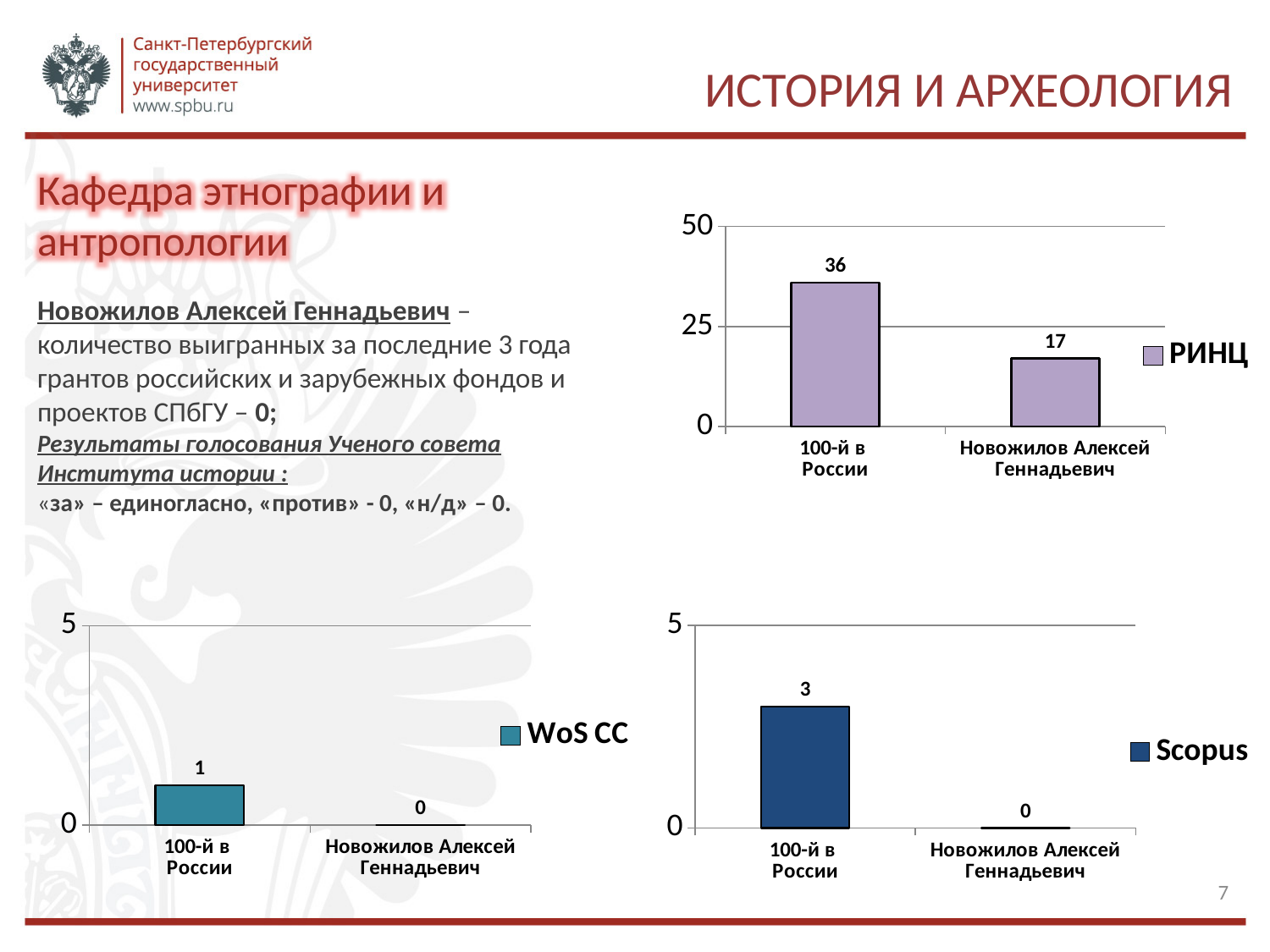
In the РИНЦ chart, is the value for Новожилов Алексей Геннадьевич greater or less than 25? less In the Scopus chart, what is the difference between the values for 100-й в России and Новожилов Алексей Геннадьевич? 3 In the РИНЦ chart, what is the value for Новожилов Алексей Геннадьевич? 17 In the РИНЦ chart, what is the difference between the values for 100-й в России and Новожилов Алексей Геннадьевич? 19 In the Scopus chart, which category has the lowest value? Новожилов Алексей Геннадьевич In the WoS CC chart, what is the value for Новожилов Алексей Геннадьевич? 0 In the РИНЦ chart, what is the value for 100-й в России? 36 How many categories are shown in the WoS CC chart? 2 What type of chart is the Scopus chart? bar chart In the Scopus chart, what is the value for 100-й в России? 3 In the РИНЦ chart, which category has the highest value? 100-й в России In the WoS CC chart, what is the value for 100-й в России? 1